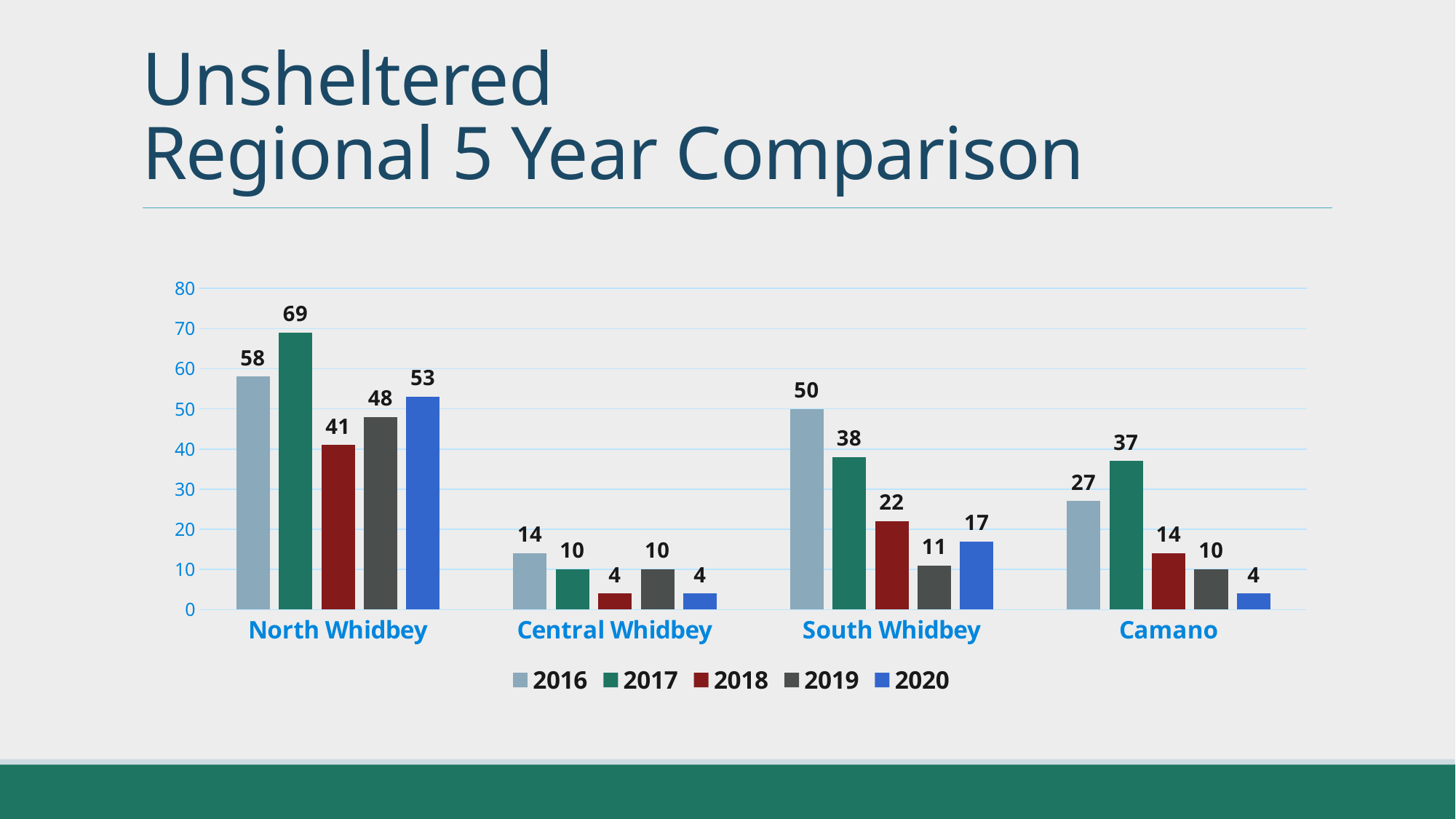
How many series does the legend list? 5 How many regions are shown on the x axis? 4 Is the value for South Whidbey in 2016 greater or less than 40? greater Which region has the highest value in 2016? North Whidbey Which is larger: the 2019 value for South Whidbey or the 2019 value for Camano? South Whidbey What kind of chart is shown on the slide? Bar chart What is the value for Camano in 2016? 27 What is the title of the slide? Unsheltered Regional 5 Year Comparison What is the value for South Whidbey in 2020? 17 Which region has the lowest value in 2020? Central Whidbey and Camano (both 4) What is the difference between the 2017 and 2018 values for North Whidbey? 28 What is the value for North Whidbey in 2017? 69